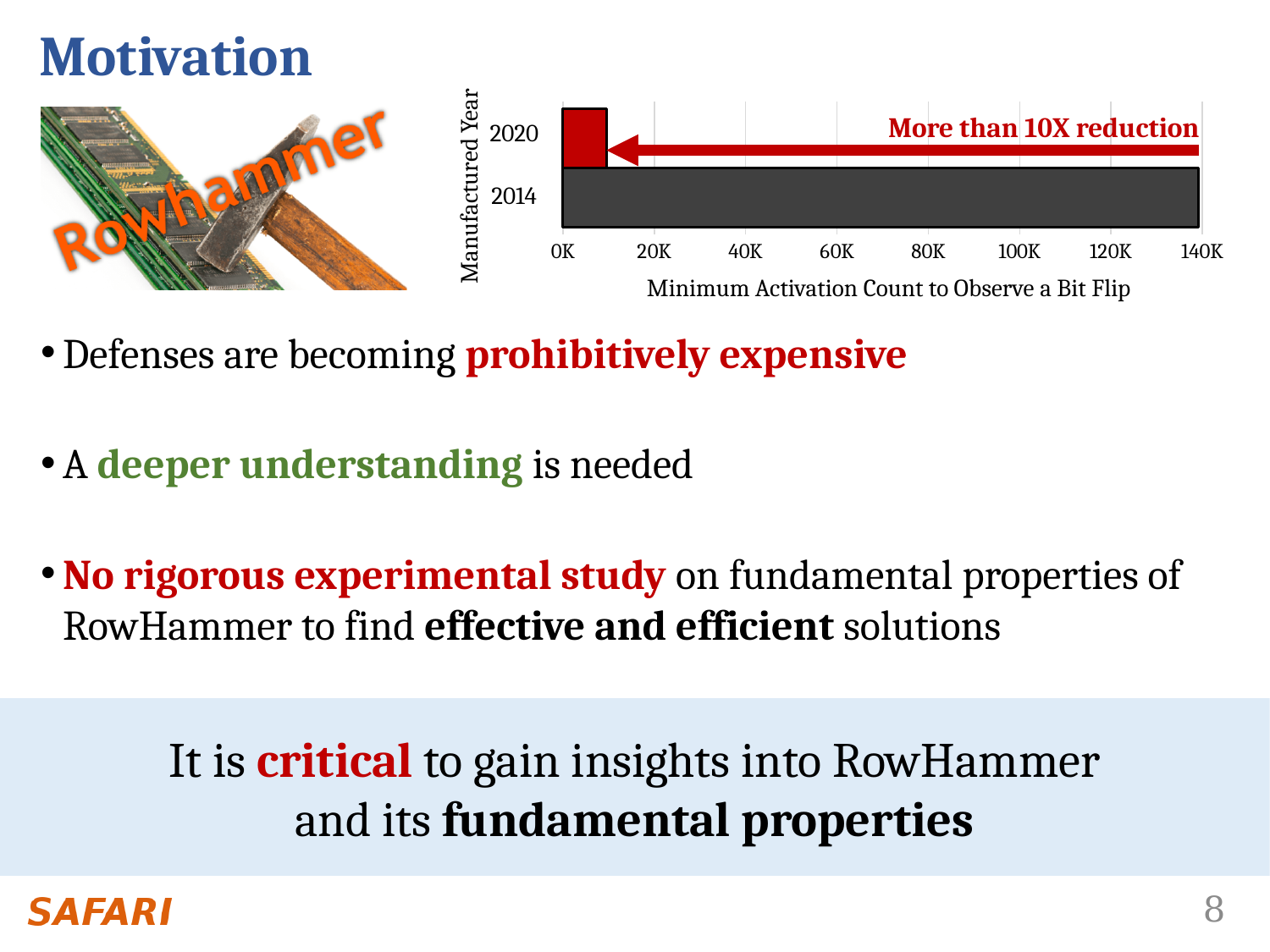
How many manufactured years (categories) are plotted in the chart? 2 What reduction does the annotation on the chart state? More than 10X reduction Is the value for 2020 greater or less than 20K? less Which manufactured year has the highest minimum activation count to observe a bit flip? 2014 Which manufactured year has the lowest minimum activation count to observe a bit flip? 2020 Is the value for 2020 greater or less than 40K? less Is the value for 2014 greater or less than 120K? greater Which has a larger minimum activation count, 2014 or 2020? 2014 What is the label of the horizontal axis of the chart? Minimum Activation Count to Observe a Bit Flip What kind of chart is shown on the slide? bar chart